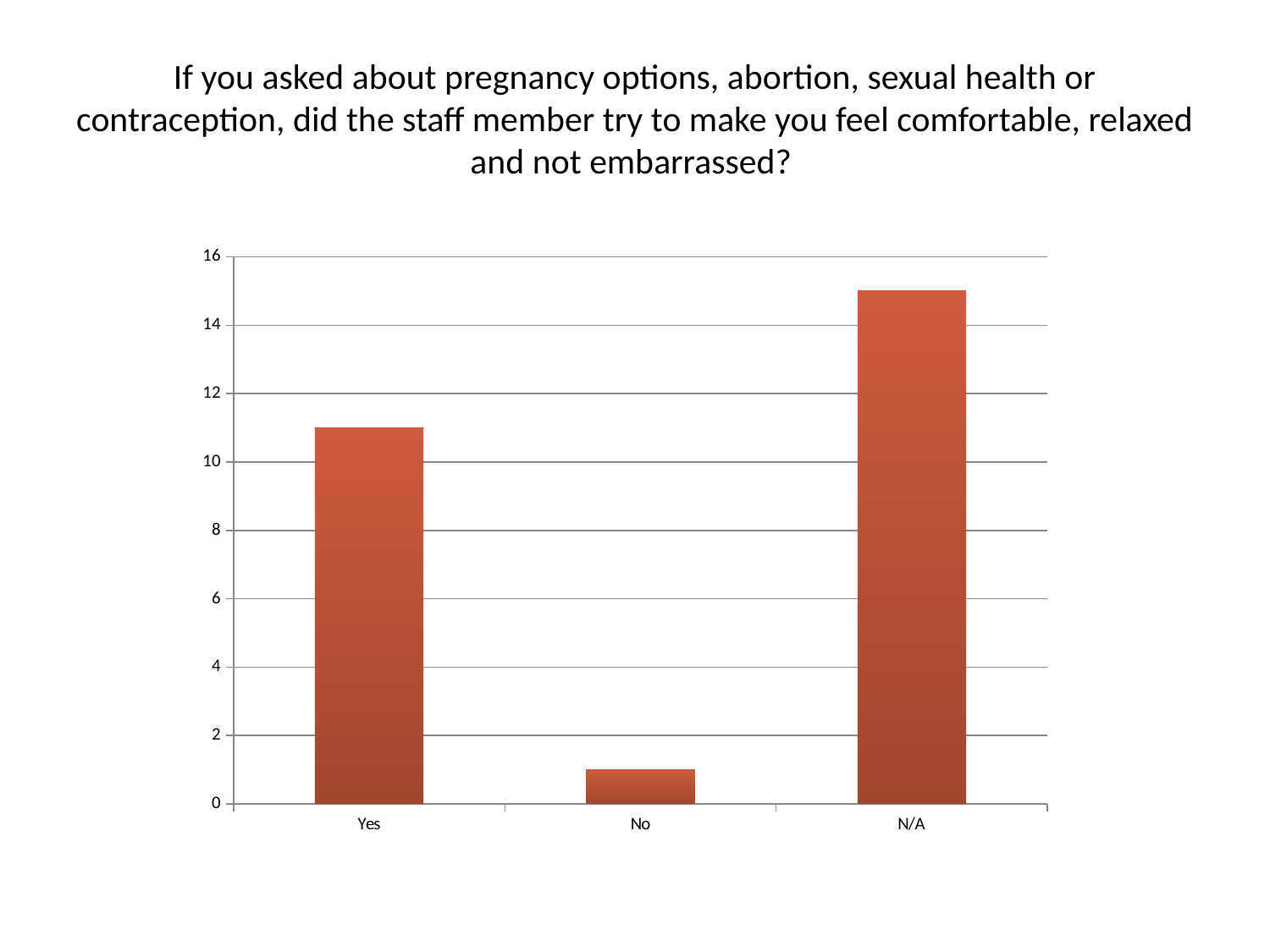
What is the highest value shown on the y axis? 16 Which is larger, the value for Yes or the value for No? Yes How many categories are shown on the x axis? 3 Is the value for N/A greater or less than 14? greater Which is larger, the value for Yes or the value for N/A? N/A Which category has the lowest bar? No Is the value for Yes greater or less than 10? greater What kind of chart is shown on the slide? bar chart Which category has the highest bar? N/A Is the value for No greater or less than 2? less What are the three category labels on the x axis? Yes, No, N/A